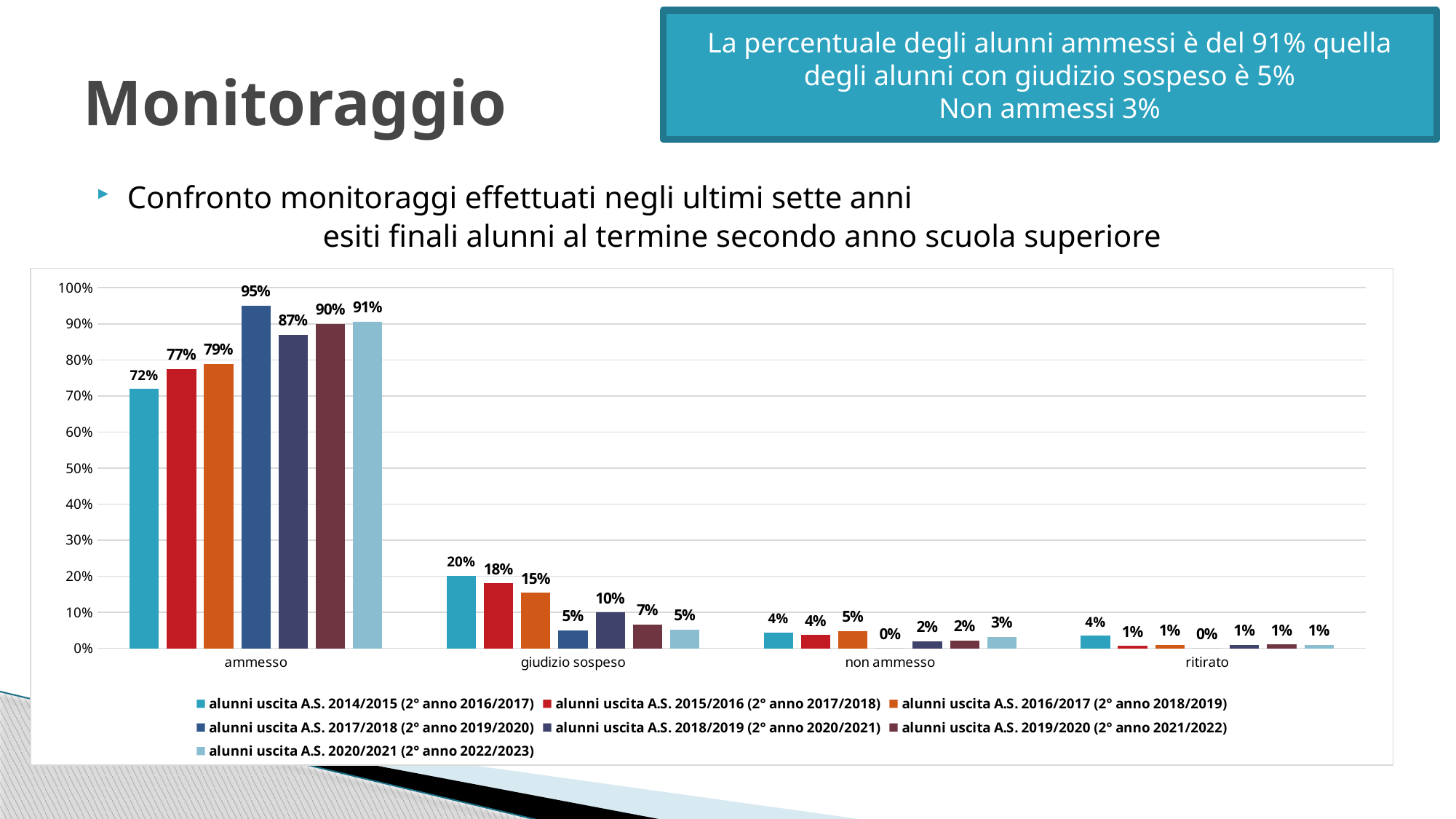
For "giudizio sospeso", which is larger: the value for "alunni uscita A.S. 2015/2016 (2° anno 2017/2018)" or for "alunni uscita A.S. 2018/2019 (2° anno 2020/2021)"? alunni uscita A.S. 2015/2016 (2° anno 2017/2018) Is the value for "ammesso" for the series "alunni uscita A.S. 2016/2017 (2° anno 2018/2019)" greater or less than 70%? greater What is the value for "ritirato" for the series "alunni uscita A.S. 2017/2018 (2° anno 2019/2020)"? 0% How many categories are shown on the x axis of the chart? 4 How many series does the legend of the chart list? 7 What kind of chart is shown on the slide? bar chart What is the difference between the "ammesso" values for the series "alunni uscita A.S. 2020/2021 (2° anno 2022/2023)" and "alunni uscita A.S. 2014/2015 (2° anno 2016/2017)"? 19% What is the value for "ammesso" for the series "alunni uscita A.S. 2017/2018 (2° anno 2019/2020)"? 95% Which series has the lowest value for "ammesso"? alunni uscita A.S. 2014/2015 (2° anno 2016/2017) Which series has the highest value for "ammesso"? alunni uscita A.S. 2017/2018 (2° anno 2019/2020) What is the value for "non ammesso" for the series "alunni uscita A.S. 2020/2021 (2° anno 2022/2023)"? 3% What is the value for "giudizio sospeso" for the series "alunni uscita A.S. 2014/2015 (2° anno 2016/2017)"? 20%